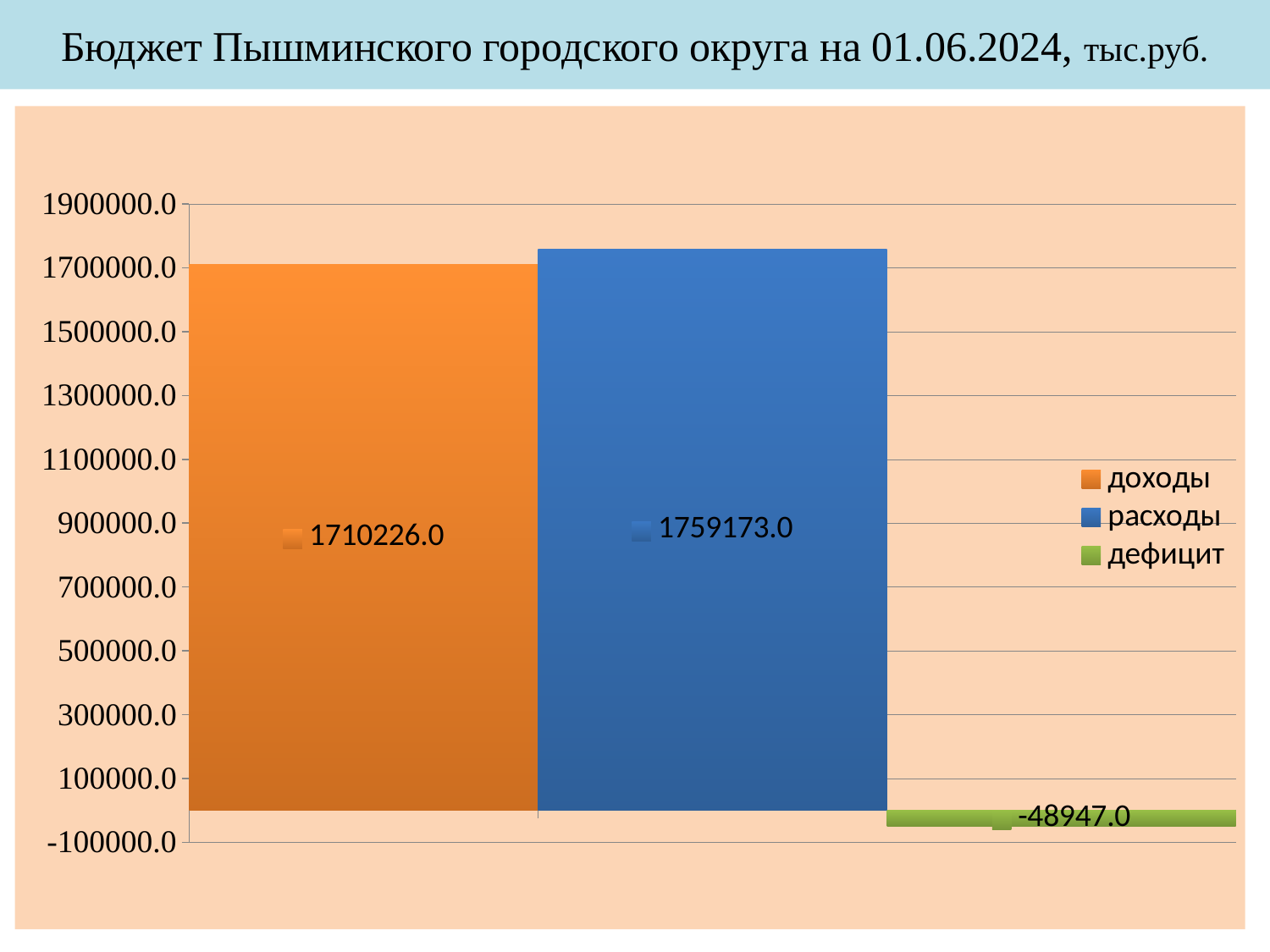
What is the difference between расходы and доходы? 48947.0 Is the value for дефицит greater or less than 100000? less What is the title of the slide? Бюджет Пышминского городского округа на 01.06.2024, тыс.руб. Which series has the highest value? расходы What is the value for дефицит? -48947.0 What kind of chart is shown on the slide? bar chart Which is larger, доходы or расходы? расходы How many series does the legend list? 3 Is the value for расходы greater or less than 1500000? greater Which series has the lowest value? дефицит What is the value for доходы? 1710226.0 What is the value for расходы? 1759173.0